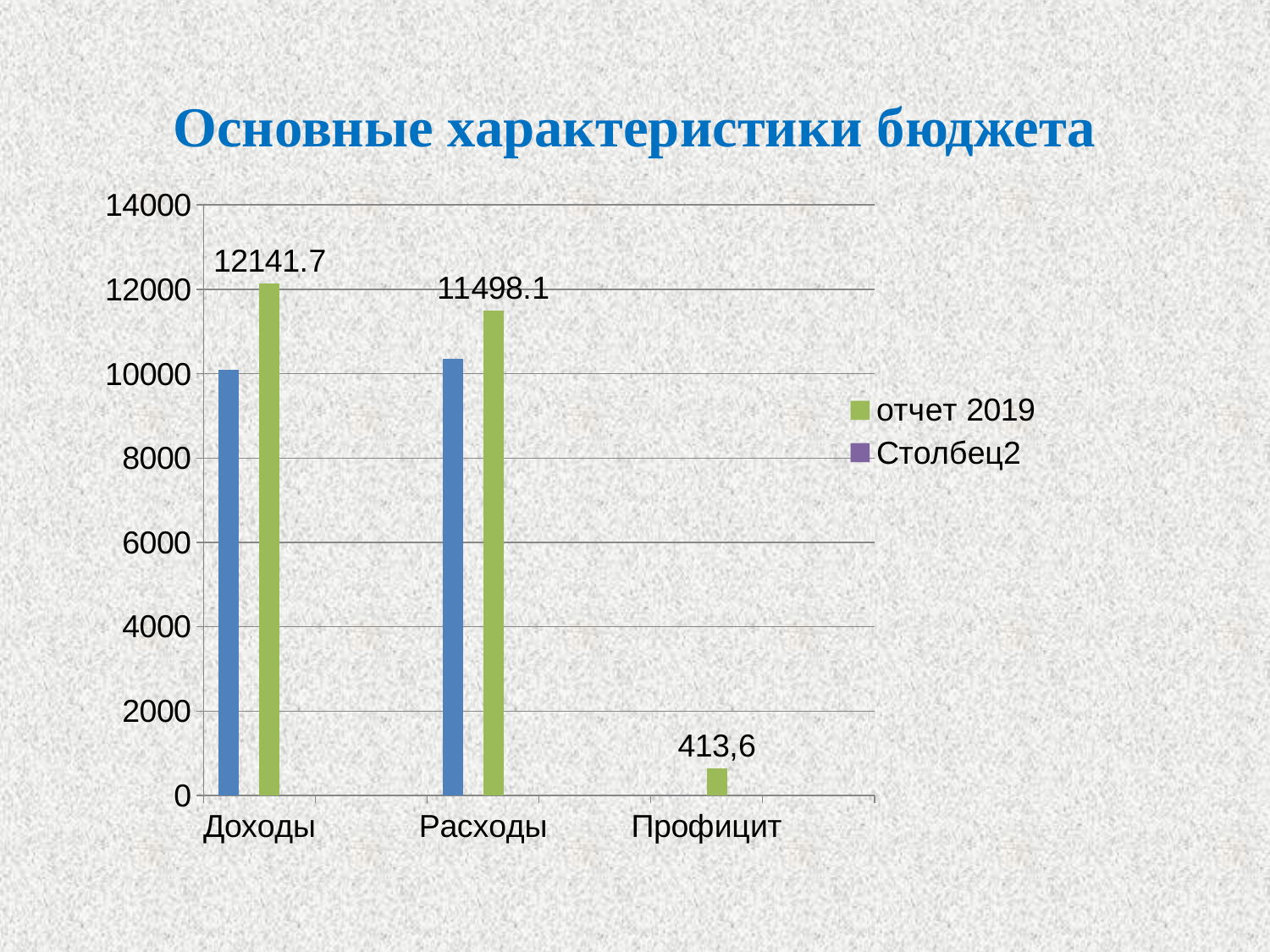
How many series does the legend list? 2 What kind of chart is shown on the slide? bar chart How many categories are shown on the x axis? 3 What is the value of the 'отчет 2019' bar for Расходы? 11498.1 Which category has the lowest 'отчет 2019' value? Профицит What is the difference between the 'отчет 2019' values for Доходы and Расходы? 643.6 What is the value of the 'отчет 2019' bar for Профицит? 413,6 Which is larger for 'отчет 2019': Доходы or Расходы? Доходы Is the value of the blue bar for Расходы greater or less than 10000? greater What is the value of the 'отчет 2019' bar for Доходы? 12141.7 Is the value of the blue bar for Доходы greater or less than 12000? less Which category has the highest 'отчет 2019' value? Доходы